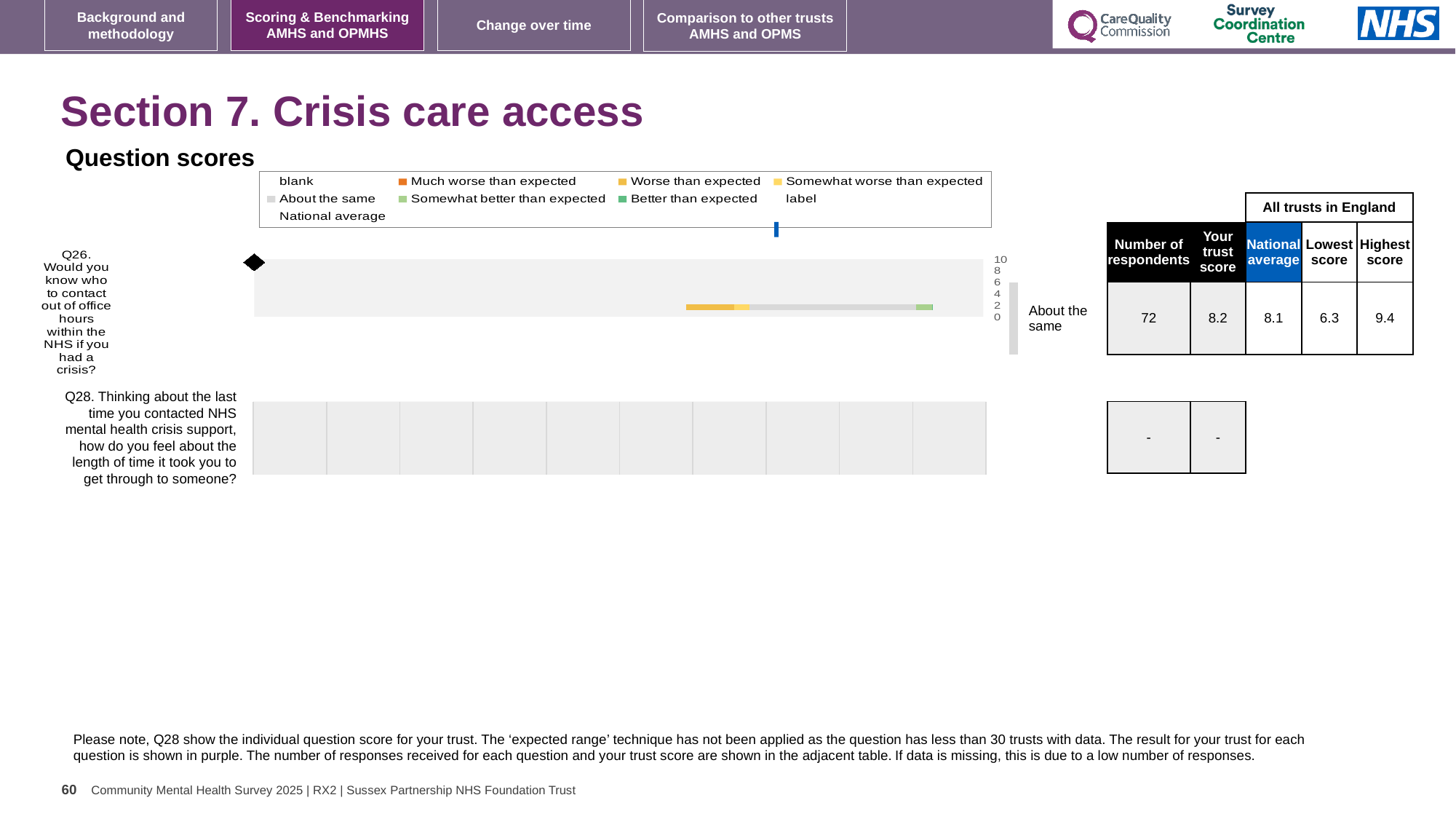
Which legend entry in the question scores chart is shown in orange? Much worse than expected What is the number of respondents for Q26 in the table next to the chart? 72 Which legend entry in the question scores chart is shown in dark green? Better than expected What is the lowest score among all trusts in England for Q26? 6.3 What is the national average for Q26 shown in the table next to the chart? 8.1 What kind of chart is used to show the question scores on this slide? bar chart What is the difference between the highest and lowest scores for Q26 across all trusts in England? 3.1 What is the highest score among all trusts in England for Q26? 9.4 What expected-range category label is shown for Q26 in the question scores chart? About the same What is the trust score for Q26 shown in the table next to the chart? 8.2 Which is larger for Q26, the trust score or the national average? trust score